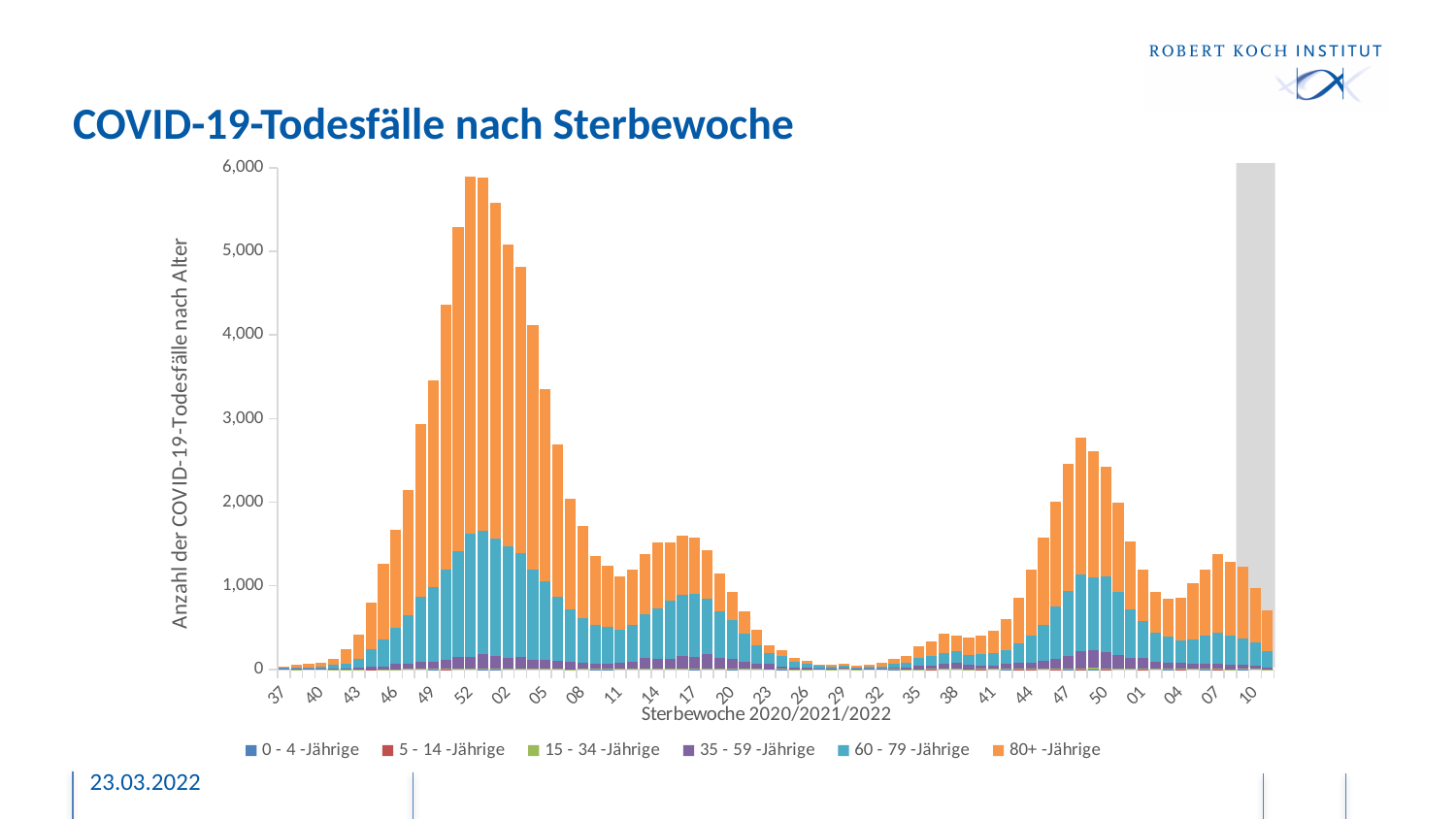
Is the total value for week 52 greater or less than 5,000? greater Is the total value for week 41 greater or less than 1,000? less What kind of chart is shown on the slide? Stacked bar chart Which week has the larger total, week 52 or week 47? Week 52 Which age group is shown in orange in the legend? 80+ -Jährige Do the total values rise or fall from week 02 to week 29? Fall Is the total value for week 47 greater or less than 2,000? greater How many series does the legend list? 6 Do the total values rise or fall from week 37 to week 52? Rise What is the title of the chart? COVID-19-Todesfälle nach Sterbewoche